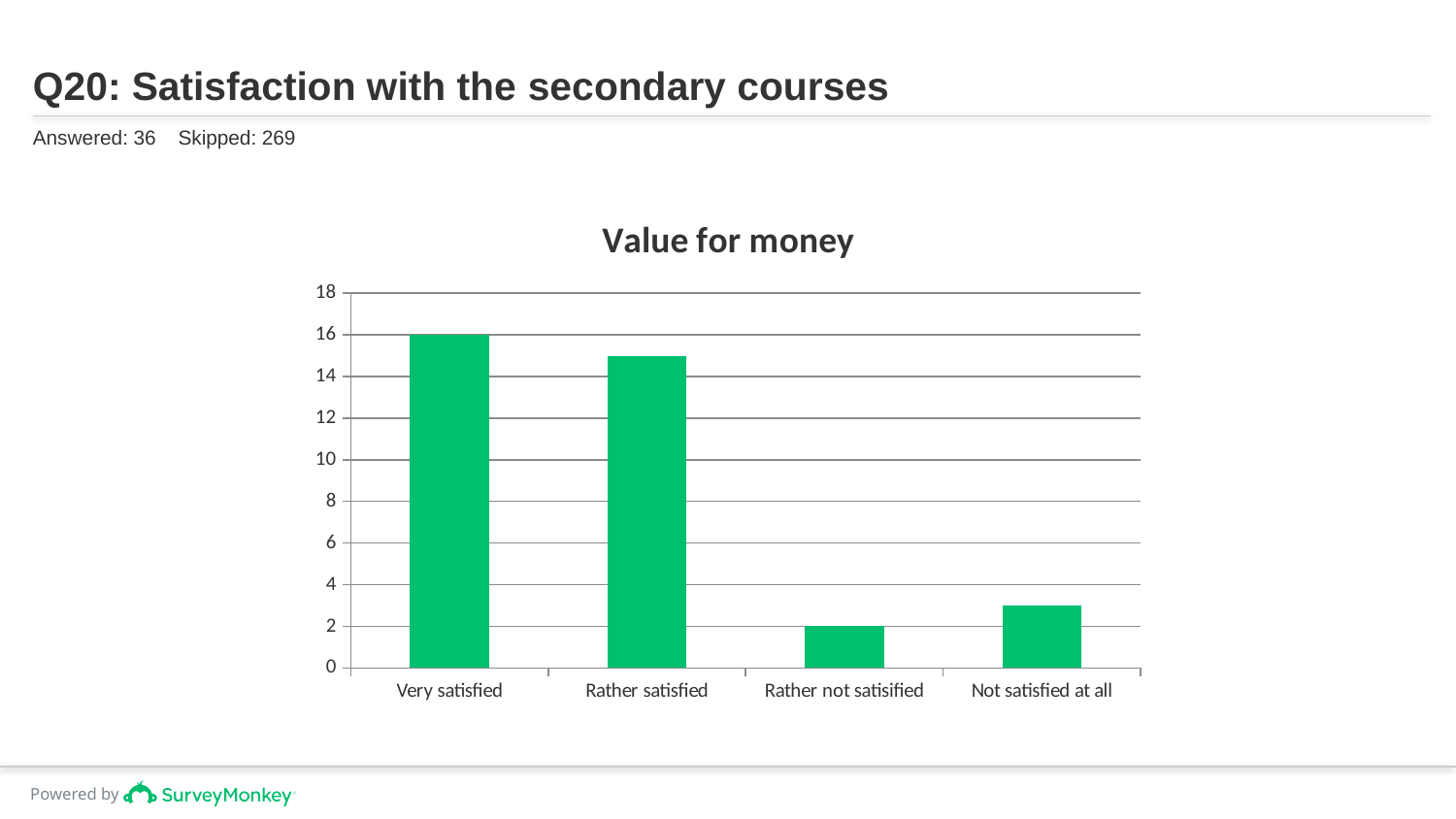
Is the value for Rather satisfied greater or less than 14? greater Which is larger, the value for Not satisfied at all or the value for Rather not satisified? Not satisfied at all Which is larger, the value for Very satisfied or the value for Rather satisfied? Very satisfied Is the value for Not satisfied at all greater or less than 4? less What is the title of the chart? Value for money What is the value for Very satisfied? 16 What is the value for Rather not satisified? 2 What kind of chart is shown on the slide? bar chart What is the difference between the values for Very satisfied and Rather not satisified? 14 Which category has the highest value? Very satisfied Which category has the lowest value? Rather not satisified How many categories are shown on the x axis? 4